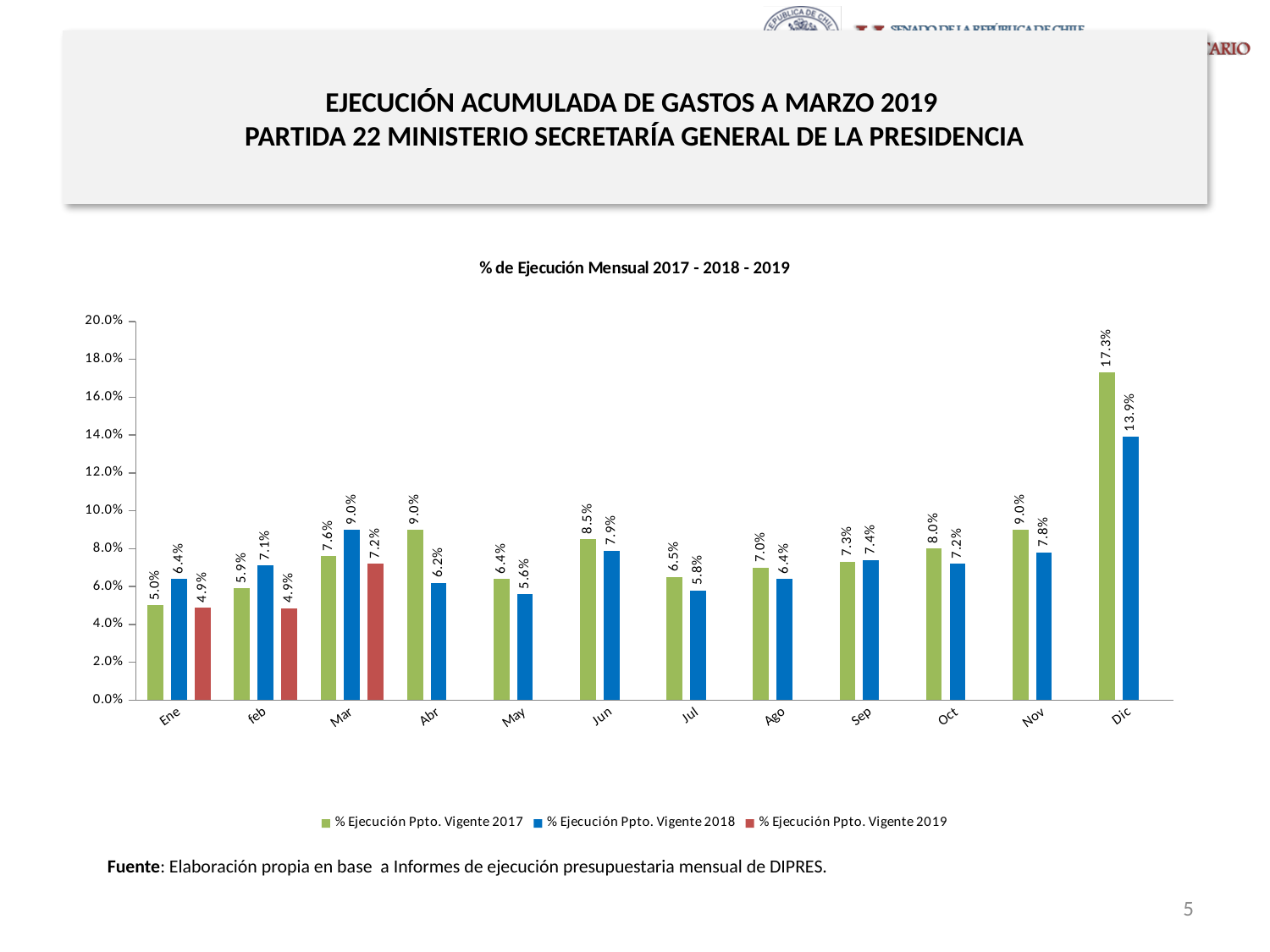
Which is larger in Abr: the 2017 value or the 2018 value? 2017 (9.0%) What is the value for % Ejecución Ppto. Vigente 2018 in Jun? 7.9% In which month is the % Ejecución Ppto. Vigente 2018 value highest? Dic What is the value for % Ejecución Ppto. Vigente 2017 in Dic? 17.3% How many series does the legend list? 3 What kind of chart is shown? Bar chart How many months are shown on the x axis? 12 Is the value for % Ejecución Ppto. Vigente 2018 in Mar greater or less than 8.0%? greater In which month is the % Ejecución Ppto. Vigente 2017 value lowest? Ene What is the difference between the 2017 and 2018 values in Dic? 3.4% What is the title of the chart? % de Ejecución Mensual 2017 - 2018 - 2019 What is the value for % Ejecución Ppto. Vigente 2019 in Mar? 7.2%